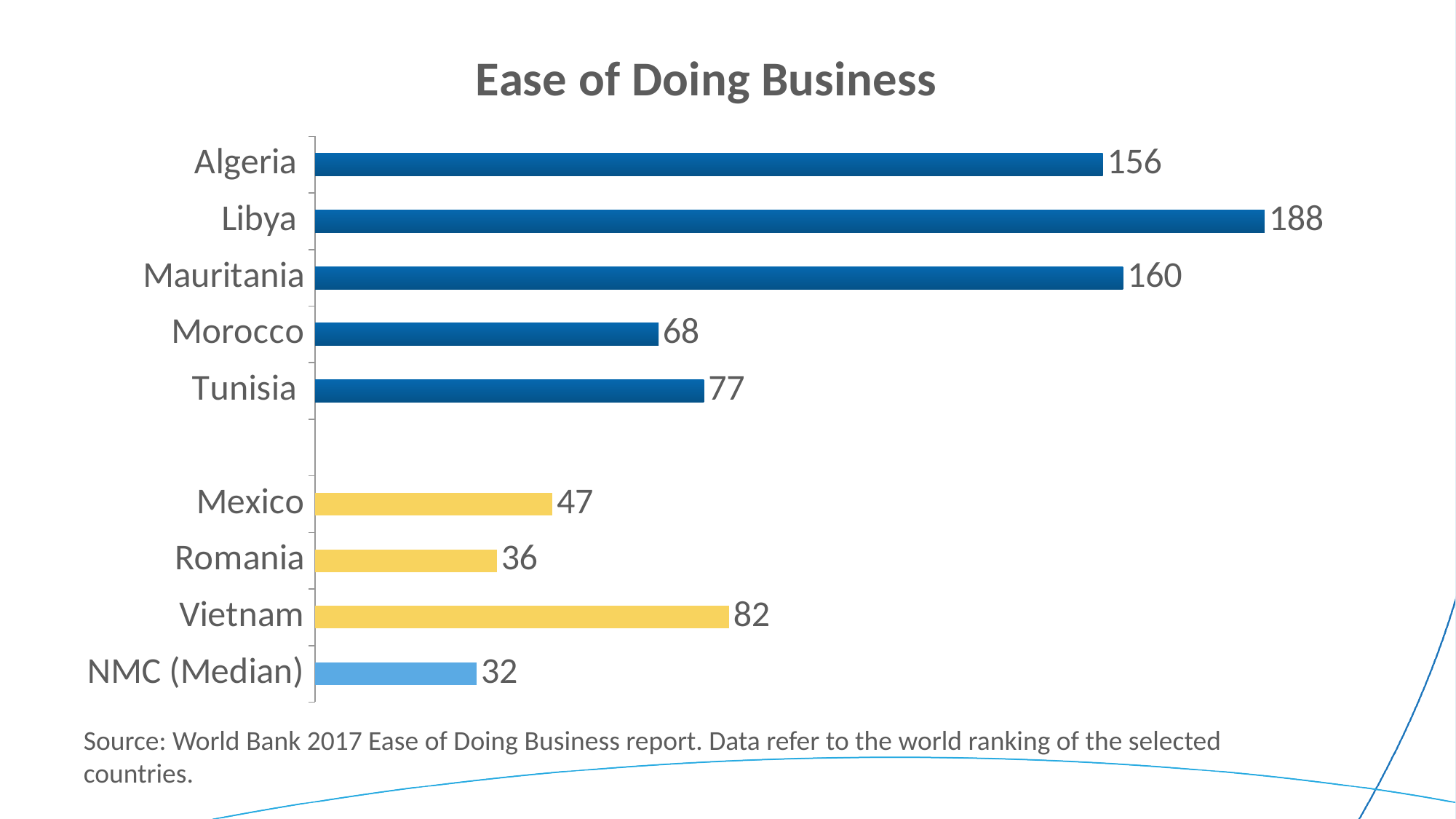
What is the title of the chart? Ease of Doing Business What kind of chart is shown on the slide? Bar chart How many categories (bars) are shown on the chart? 9 Which category has the lowest value on the chart? NMC (Median) What is the value shown for NMC (Median)? 32 What is the value shown for Morocco? 68 What is the Ease of Doing Business value for Libya? 188 Which has a larger value, Mexico or Romania? Mexico What is the value shown for Vietnam? 82 Which country has the highest value on the chart? Libya What is the difference between the values for Mauritania and Algeria? 4 What is the difference between the values for Tunisia and Morocco? 9